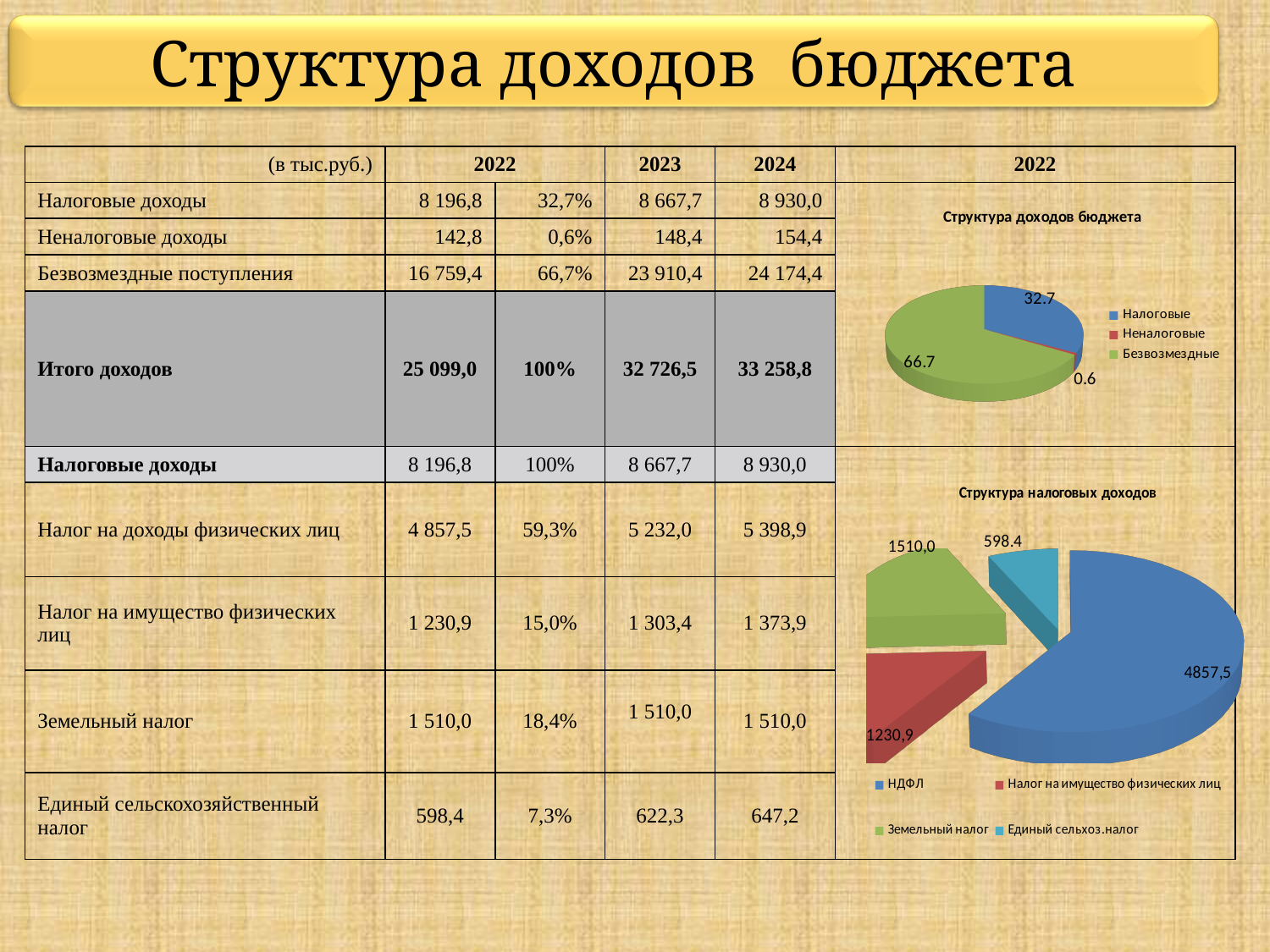
In the chart titled "Структура доходов бюджета", what value is shown for the Налоговые slice? 32.7 In the chart titled "Структура налоговых доходов", which category has the largest slice? НДФЛ In the chart titled "Структура налоговых доходов", what value is shown for НДФЛ? 4857,5 What kind of chart is the chart titled "Структура налоговых доходов"? Pie chart In the chart titled "Структура налоговых доходов", what value is shown for Земельный налог? 1510,0 In the chart titled "Структура доходов бюджета", which category has the largest slice? Безвозмездные In the chart titled "Структура доходов бюджета", which category has the smallest slice? Неналоговые In the chart titled "Структура налоговых доходов", what value is shown for Единый сельхоз.налог? 598.4 In the chart titled "Структура доходов бюджета", what value is shown for the Безвозмездные slice? 66.7 In the chart titled "Структура налоговых доходов", which is larger: Земельный налог or Налог на имущество физических лиц? Земельный налог How many categories does the legend of the chart titled "Структура доходов бюджета" list? 3 How many slices does the chart titled "Структура налоговых доходов" have? 4